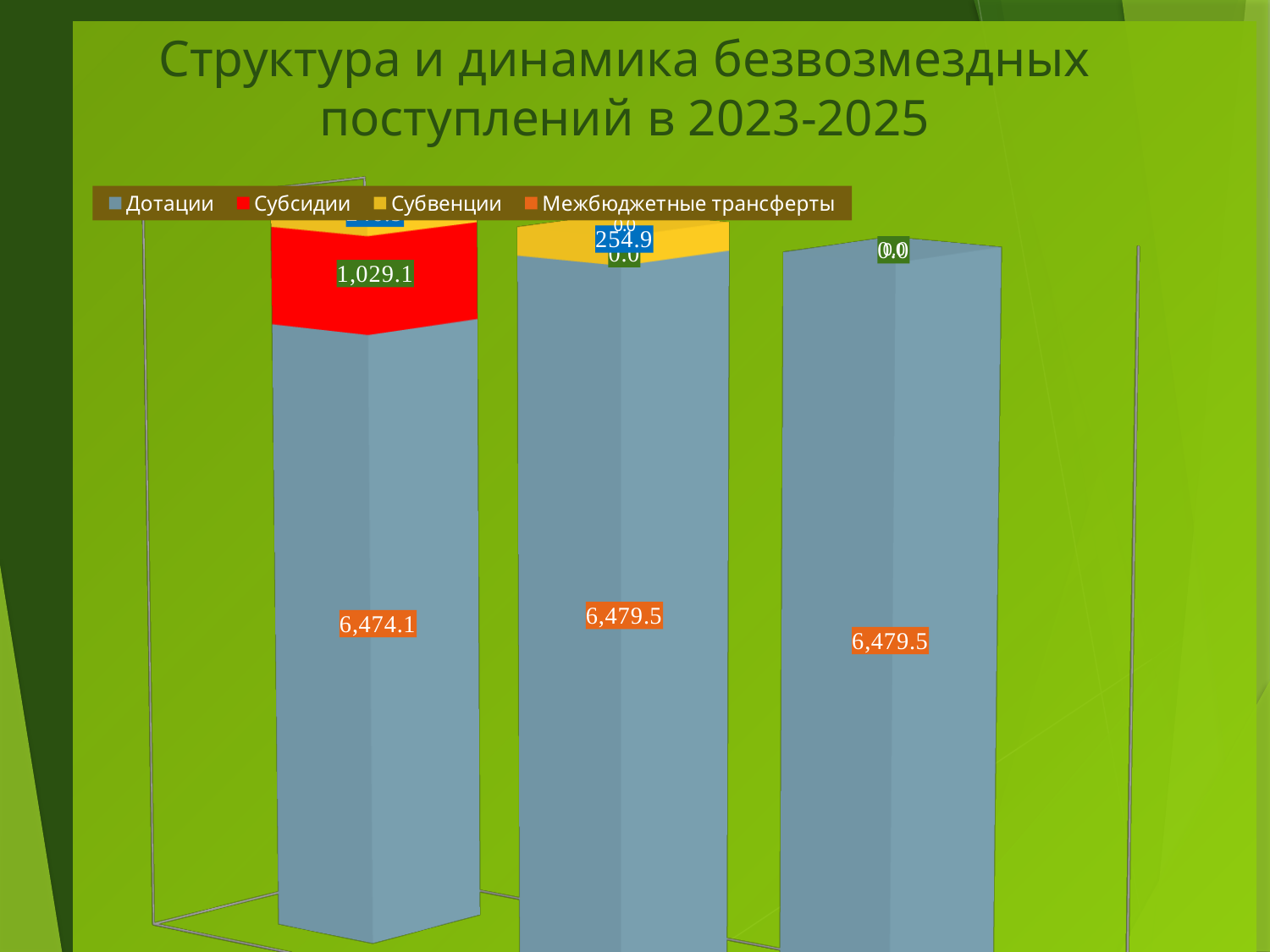
How many stacked bars are plotted in the chart? 3 What is the value of the Субвенции segment in the middle bar? 254.9 How many series does the legend list? 4 What is the value of the Дотации segment in the leftmost bar? 6,474.1 What colour represents Субсидии in the legend? red What is the value of the Дотации segment in the rightmost bar? 6,479.5 Which is larger: the Дотации value in the leftmost bar or in the middle bar? middle bar What kind of chart is shown on the slide? bar chart What is the difference between the Субсидии value in the leftmost bar (1,029.1) and the Субвенции value in the middle bar (254.9)? 774.2 What is the value of the Субсидии segment in the leftmost bar? 1,029.1 What is the total of the middle stacked bar (6,479.5 + 254.9 + 0.0 + 0.0)? 6,734.4